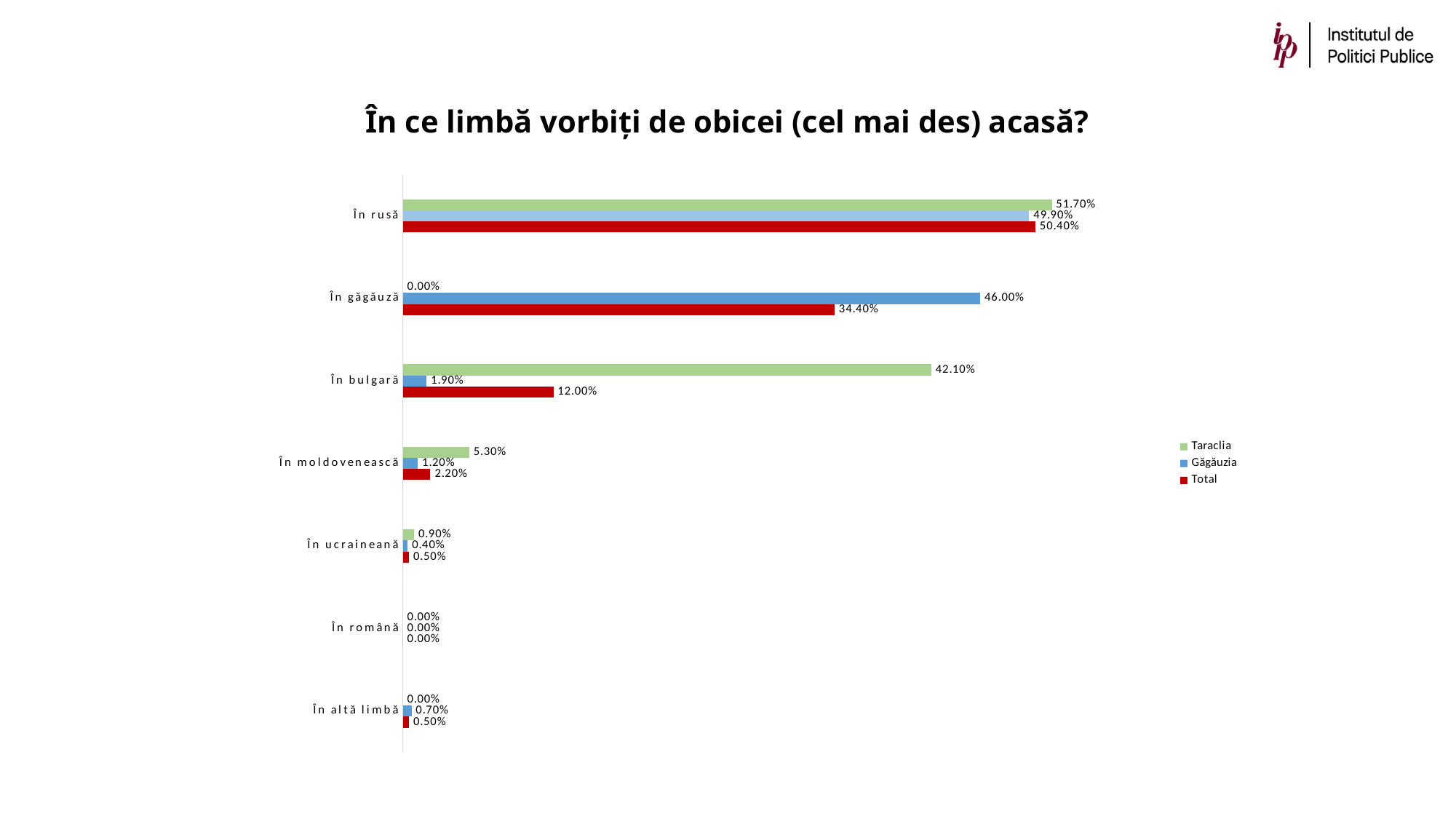
Which language category has the highest Total value? În rusă How many series does the legend list? 3 What is the difference between the Găgăuzia and Total values for În găgăuză? 11.60% What kind of chart is shown on the slide? Bar chart Which is larger for În bulgară, the Taraclia value or the Total value? Taraclia What is the Total value for În bulgară? 12.00% What is the difference between the Taraclia and Găgăuzia values for În bulgară? 40.20% What is the Taraclia value for În moldovenească? 5.30% Which language category has the highest Taraclia value? În rusă What is the Taraclia value for În rusă? 51.70% How many language categories are shown on the chart? 7 What is the Găgăuzia value for În găgăuză? 46.00%